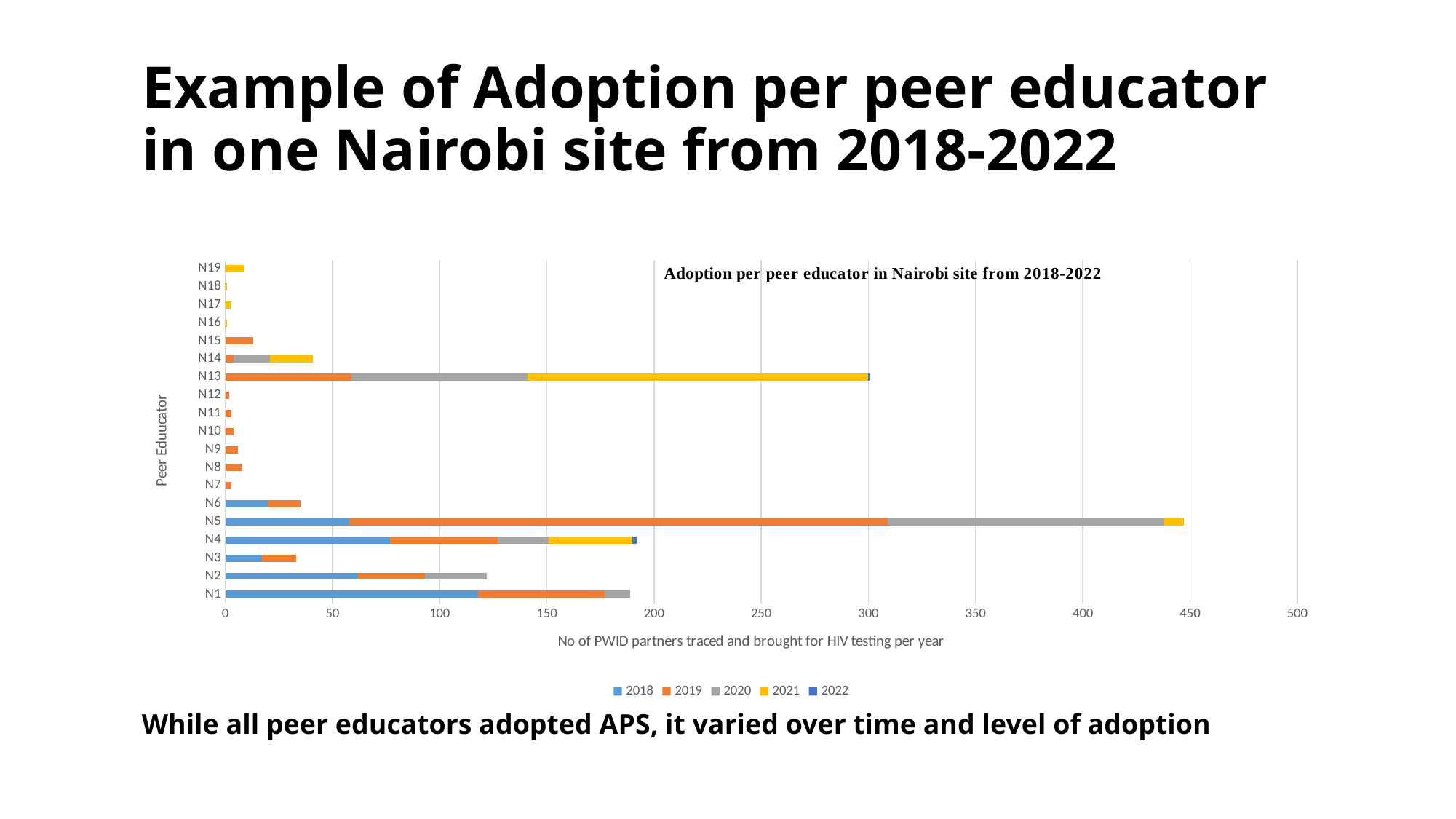
Is the total value for N6 greater or less than 50? less How many peer educators (categories) are shown on the chart? 19 How many series does the legend list? 5 Is the total value for N2 greater or less than 100? greater Which has a larger total, N5 or N13? N5 Is the total value for N1 greater or less than 150? greater Which has a larger total, N1 or N2? N1 What is the label of the horizontal axis? No of PWID partners traced and brought for HIV testing per year Which peer educator has the highest total number of PWID partners traced? N5 What kind of chart is shown on the slide? Stacked bar chart What is the title of the chart? Adoption per peer educator in Nairobi site from 2018-2022